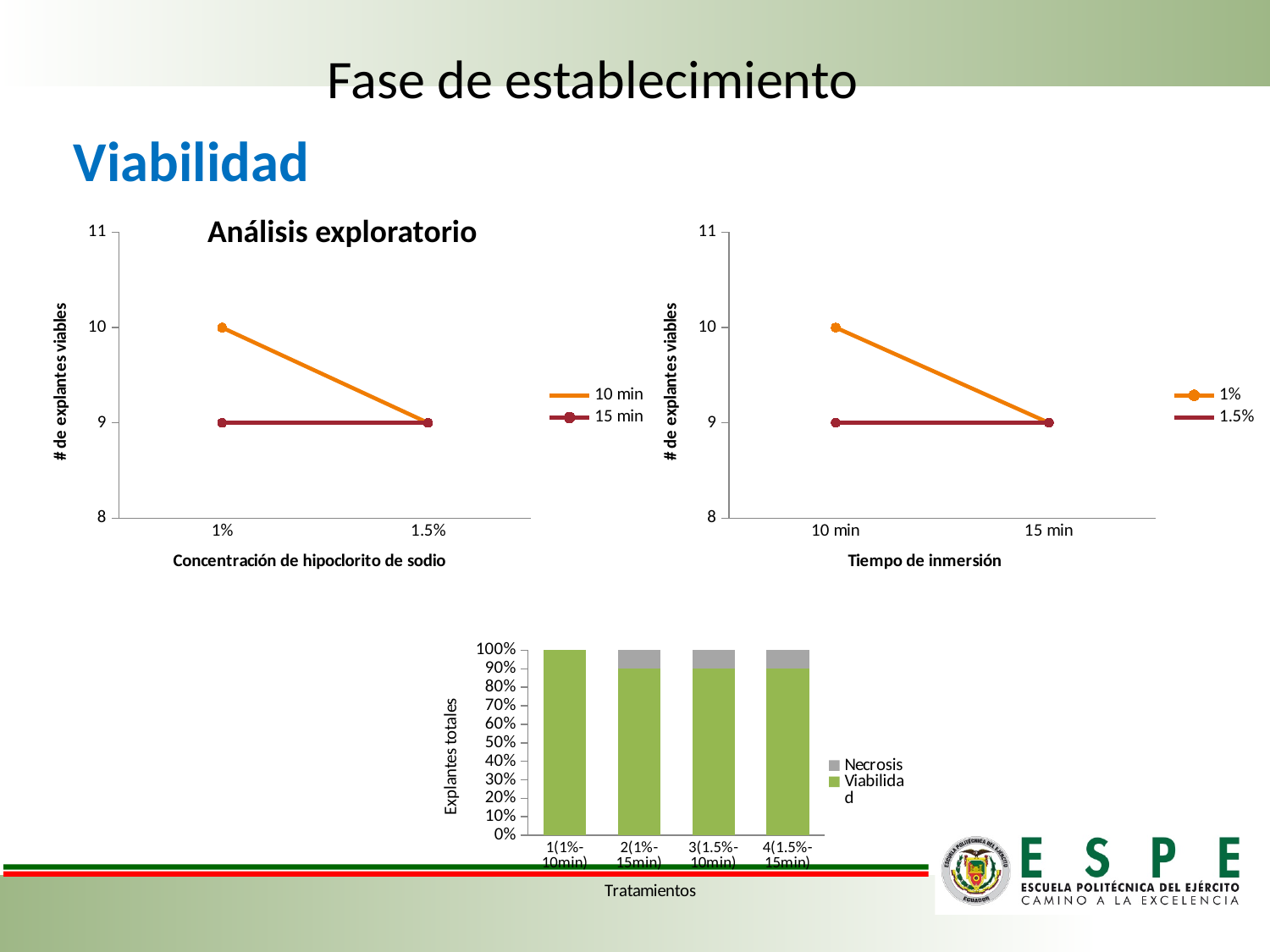
In the bottom stacked bar chart with x axis 'Tratamientos', how many treatment categories are shown? 4 In the bottom stacked bar chart with x axis 'Tratamientos', what is the Necrosis value for treatment 2(1%-15min)? 10% In the left line chart titled 'Análisis exploratorio', what is the value of the 10 min series at 1.5%? 9 In the left line chart titled 'Análisis exploratorio', how many series does the legend list? 2 In the right line chart with x axis 'Tiempo de inmersión', which series is higher at 10 min, 1% or 1.5%? 1% In the left line chart titled 'Análisis exploratorio', does the 10 min series rise or fall from 1% to 1.5%? fall In the bottom stacked bar chart with x axis 'Tratamientos', what is the Viabilidad value for treatment 1(1%-10min)? 100% In the right line chart with x axis 'Tiempo de inmersión', what is the value of the 1% series at 10 min? 10 In the left line chart titled 'Análisis exploratorio', what is the value of the 10 min series at 1%? 10 In the right line chart with x axis 'Tiempo de inmersión', what is the value of the 1.5% series at 15 min? 9 In the right line chart with x axis 'Tiempo de inmersión', what is the difference between the 1% and 1.5% series at 10 min? 1 In the left line chart titled 'Análisis exploratorio', what is the value of the 15 min series at 1%? 9